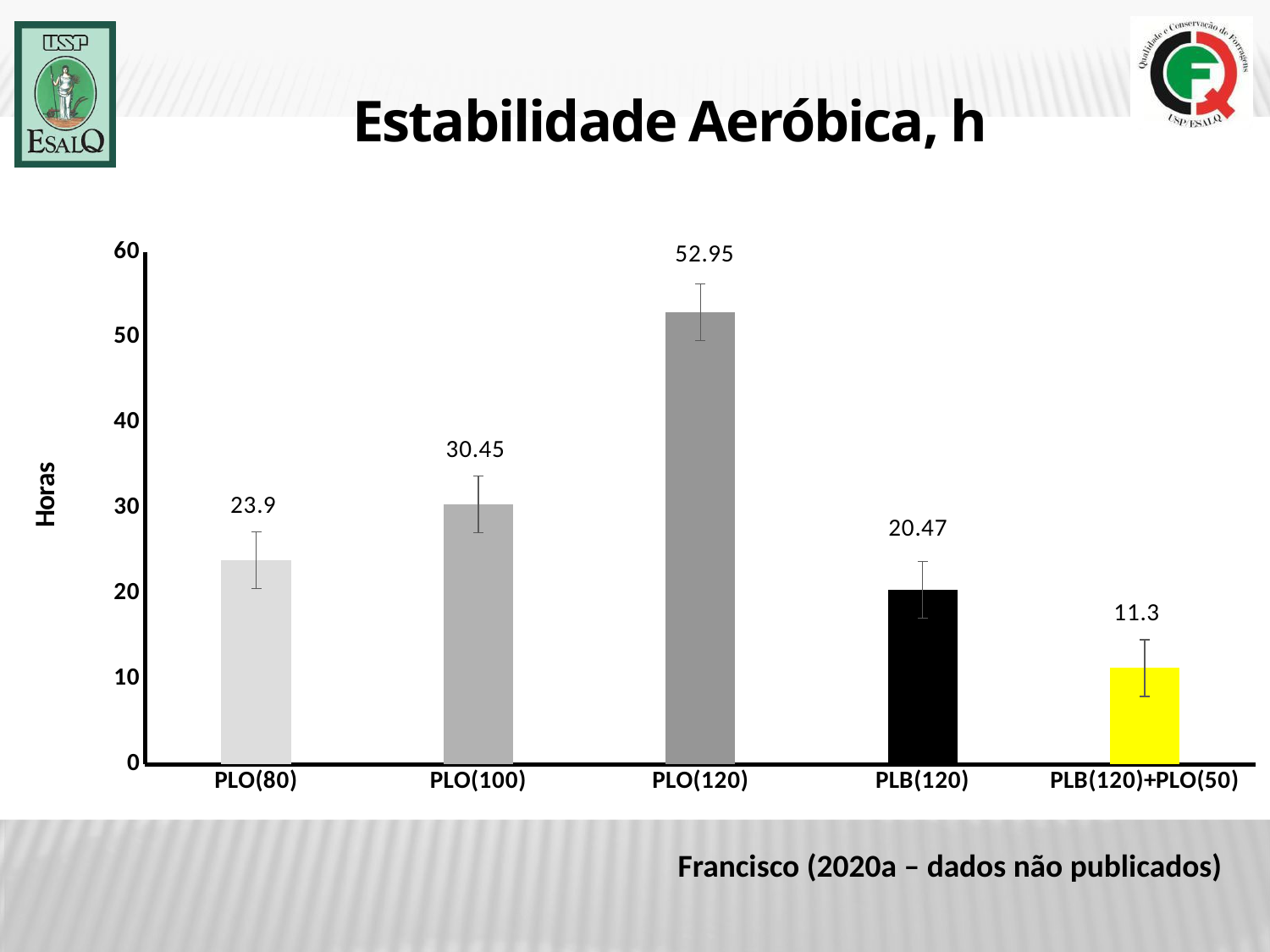
Which category has the highest value? PLO(120) Which is larger, the value for PLO(100) or the value for PLB(120)? PLO(100) Is the value for PLO(120) greater or less than 50? greater What is the value for PLO(120)? 52.95 What is the difference between the values for PLO(120) and PLO(100)? 22.5 What kind of chart is shown on the slide? bar chart Which category has the lowest value? PLB(120)+PLO(50) What is the label of the y axis? Horas What is the value for PLB(120)+PLO(50)? 11.3 How many categories are shown on the x axis? 5 What is the value for PLO(80)? 23.9 What is the difference between the values for PLO(80) and PLB(120)? 3.43